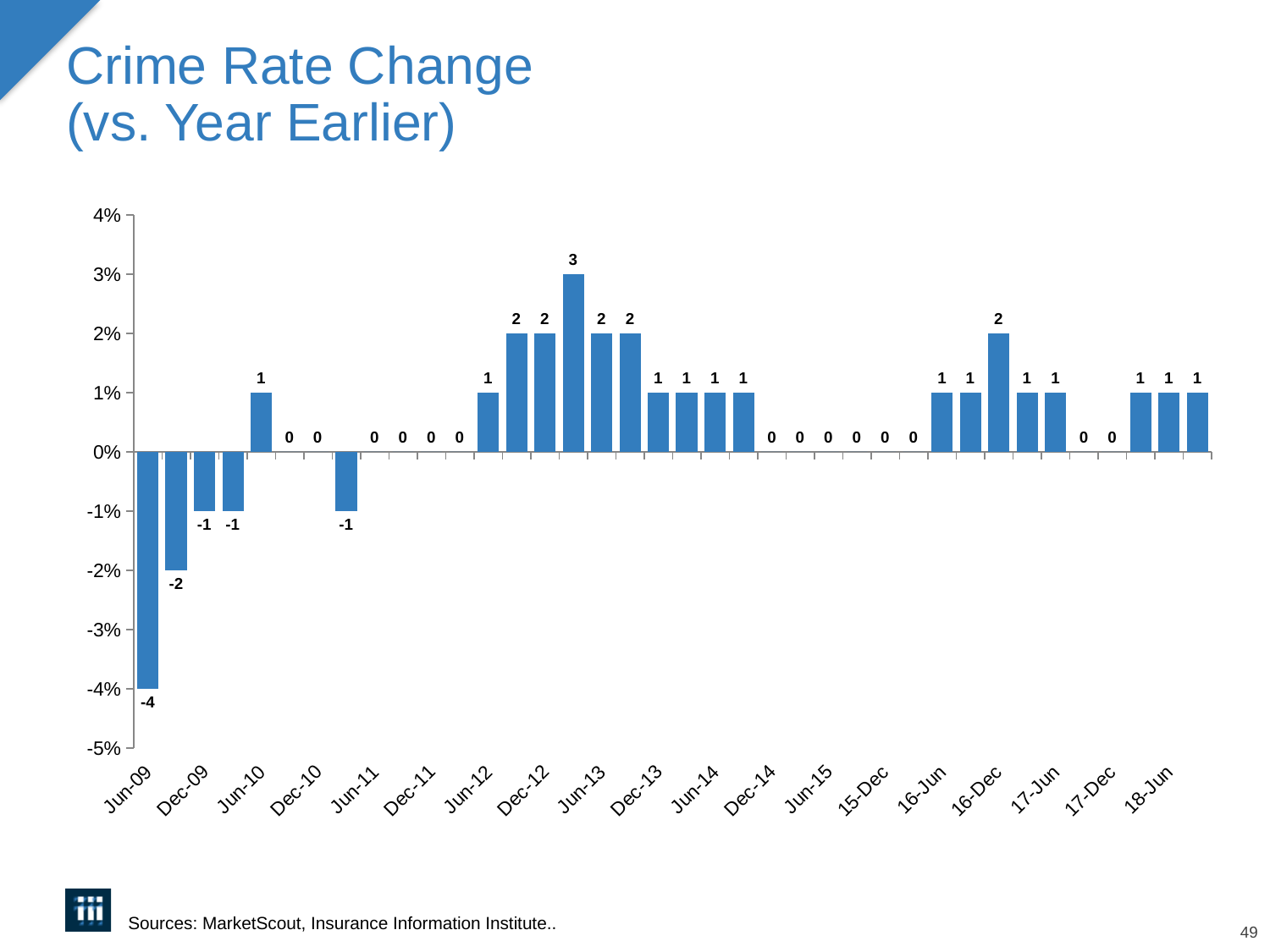
Which is larger, the value for Jun-09 or the value for 16-Dec? 16-Dec What is the crime rate change value for Jun-09? -4 What is the highest value labelled on any bar in the chart? 3 What is the lowest value labelled on any bar in the chart? -4 Is the value for Jun-09 greater or less than -3%? less What kind of chart is shown on the slide? bar chart What is the crime rate change value for 16-Dec? 2 Do the values generally rise or fall from Jun-09 to the peak bar around Jun-13? rise Is the highest bar in the chart greater or less than 2%? greater What is the difference between the highest bar value (3) and the lowest bar value (-4)? 7 What is the title of the chart on the slide? Crime Rate Change (vs. Year Earlier) What is the maximum value shown on the vertical axis? 4%